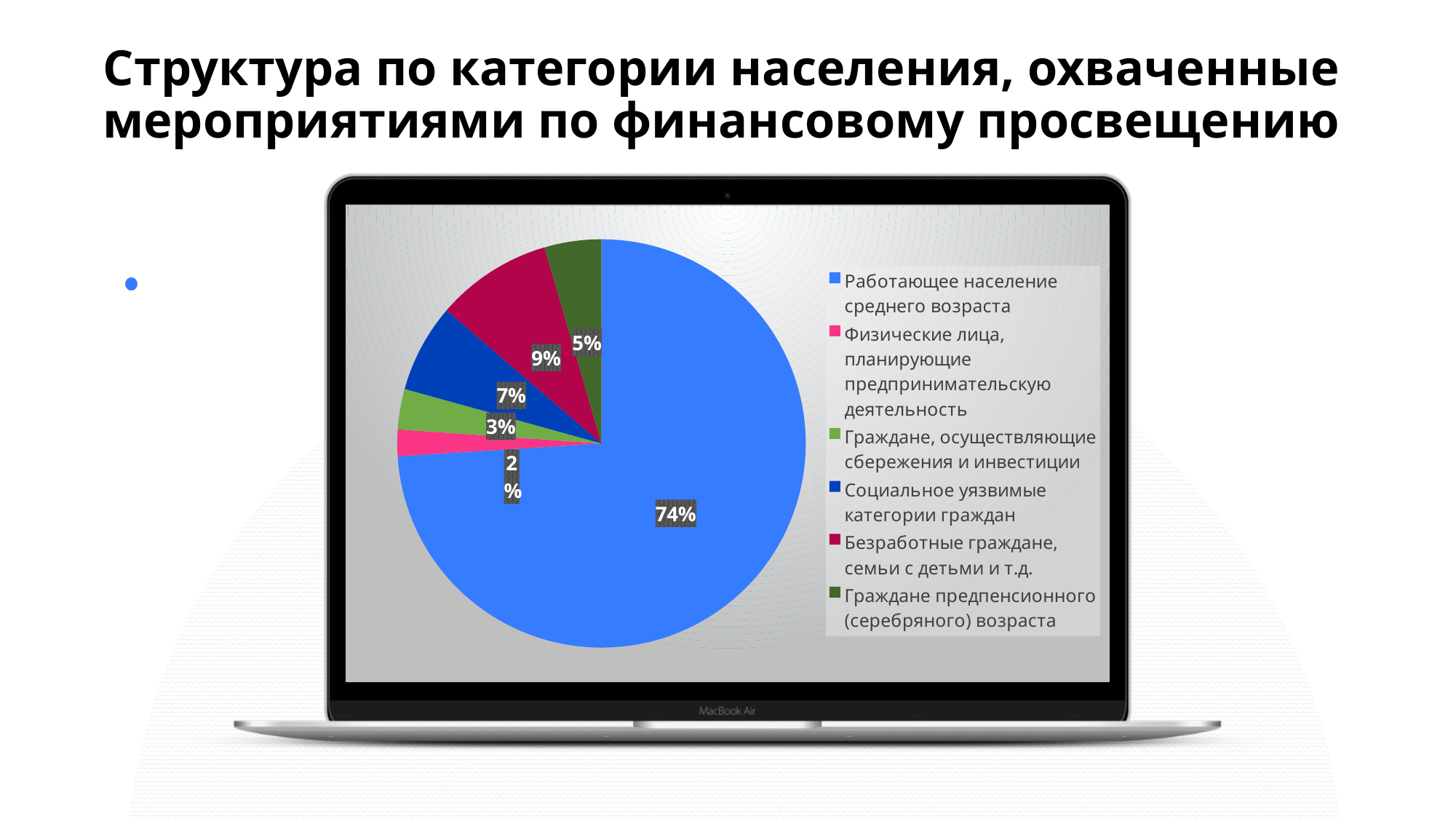
Which category has the smallest slice of the pie? Физические лица, планирующие предпринимательскую деятельность What share of the pie does "Работающее население среднего возраста" have? 74% What is the value shown for "Граждане, осуществляющие сбережения и инвестиции"? 3% What is the difference between the shares of "Безработные граждане, семьи с детьми и т.д." and "Социальное уязвимые категории граждан"? 2% What type of chart is shown on the slide? pie chart How many categories does the legend of the pie chart list? 6 What is the value shown for "Физические лица, планирующие предпринимательскую деятельность"? 2% Which is larger: the share for "Граждане предпенсионного (серебряного) возраста" or for "Граждане, осуществляющие сбережения и инвестиции"? Граждане предпенсионного (серебряного) возраста What is the value shown for "Социальное уязвимые категории граждан"? 7% What is the value shown for "Граждане предпенсионного (серебряного) возраста"? 5% What is the value shown for "Безработные граждане, семьи с детьми и т.д."? 9% Which category has the largest slice of the pie? Работающее население среднего возраста